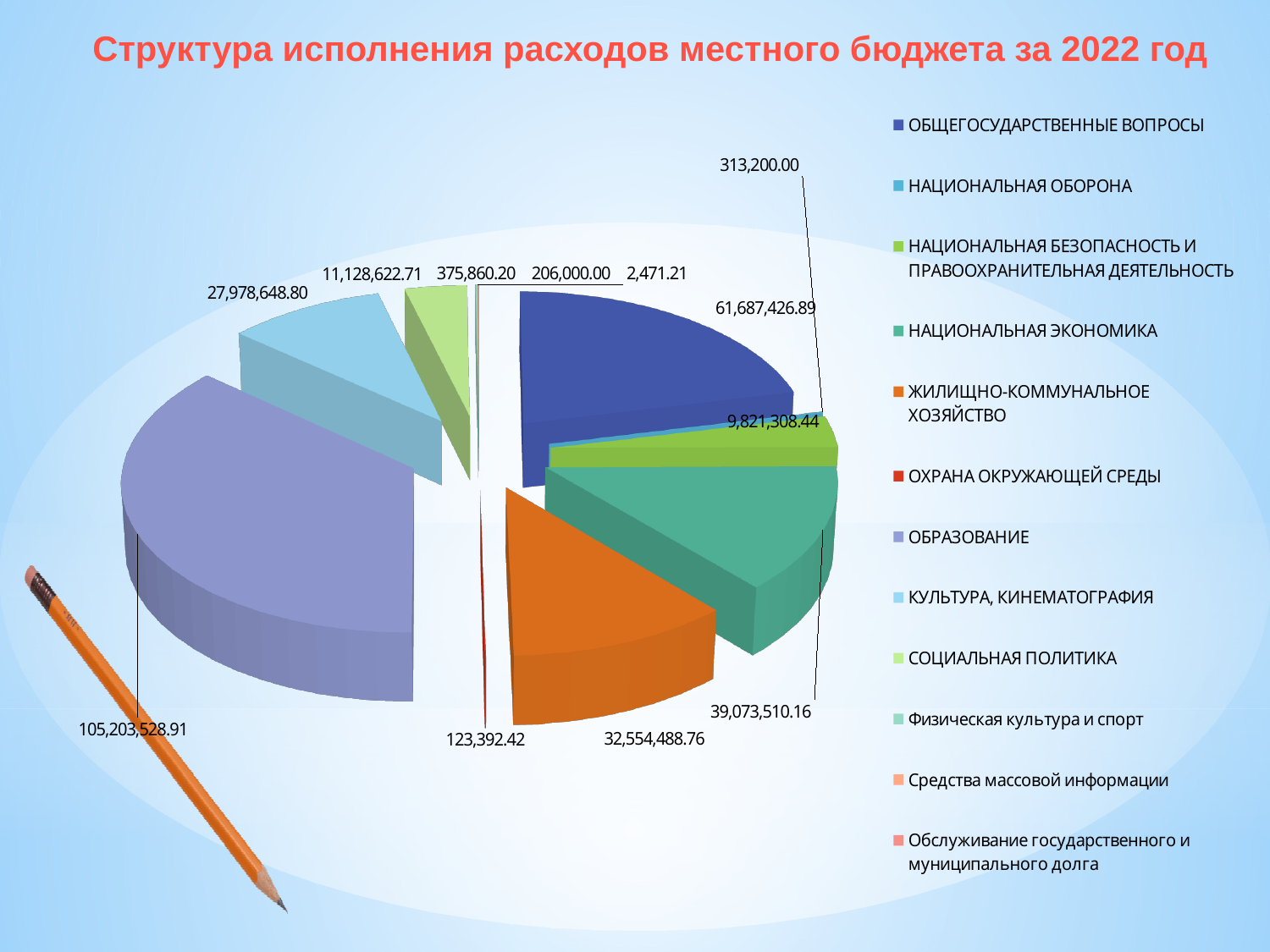
What kind of chart is shown on the slide? Pie chart What is the value for НАЦИОНАЛЬНАЯ БЕЗОПАСНОСТЬ И ПРАВООХРАНИТЕЛЬНАЯ ДЕЯТЕЛЬНОСТЬ? 9,821,308.44 What is the title of the chart on the slide? Структура исполнения расходов местного бюджета за 2022 год What is the value for ЖИЛИЩНО-КОММУНАЛЬНОЕ ХОЗЯЙСТВО? 32,554,488.76 Which is larger, НАЦИОНАЛЬНАЯ ЭКОНОМИКА or ЖИЛИЩНО-КОММУНАЛЬНОЕ ХОЗЯЙСТВО? НАЦИОНАЛЬНАЯ ЭКОНОМИКА What is the difference between the values for ОБРАЗОВАНИЕ and ОБЩЕГОСУДАРСТВЕННЫЕ ВОПРОСЫ? 43,516,102.02 What is the value for КУЛЬТУРА, КИНЕМАТОГРАФИЯ? 27,978,648.80 What is the value for ОБРАЗОВАНИЕ? 105,203,528.91 Which category has the largest slice of the pie? ОБРАЗОВАНИЕ How many categories does the legend of the pie chart list? 12 What is the value for НАЦИОНАЛЬНАЯ ЭКОНОМИКА? 39,073,510.16 What is the value for ОБЩЕГОСУДАРСТВЕННЫЕ ВОПРОСЫ? 61,687,426.89